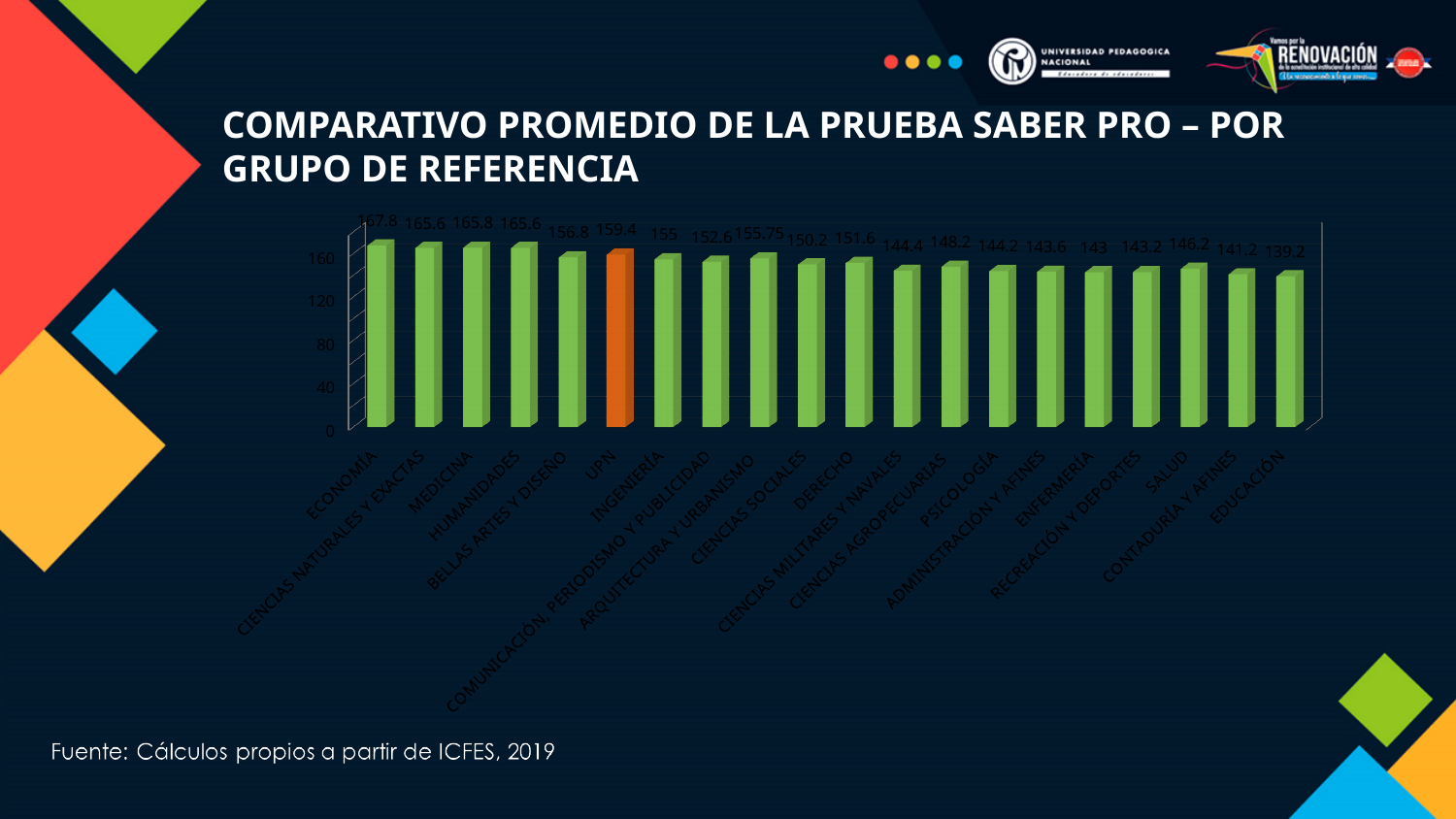
What value is shown for ARQUITECTURA Y URBANISMO? 155.75 How many reference groups are shown in the chart? 20 Which bar is shown in a different colour (orange) from the rest? UPN Which reference group has the lowest average score? EDUCACIÓN What value is shown for EDUCACIÓN? 139.2 What is the difference between the values for ECONOMÍA and UPN? 8.4 What type of chart is shown on the slide? Bar chart Is the value for PSICOLOGÍA greater or less than 160? less Which has a higher value, UPN or INGENIERÍA? UPN What value is shown for ECONOMÍA? 167.8 Which reference group has the highest average score? ECONOMÍA What is the average Saber Pro score shown for UPN? 159.4